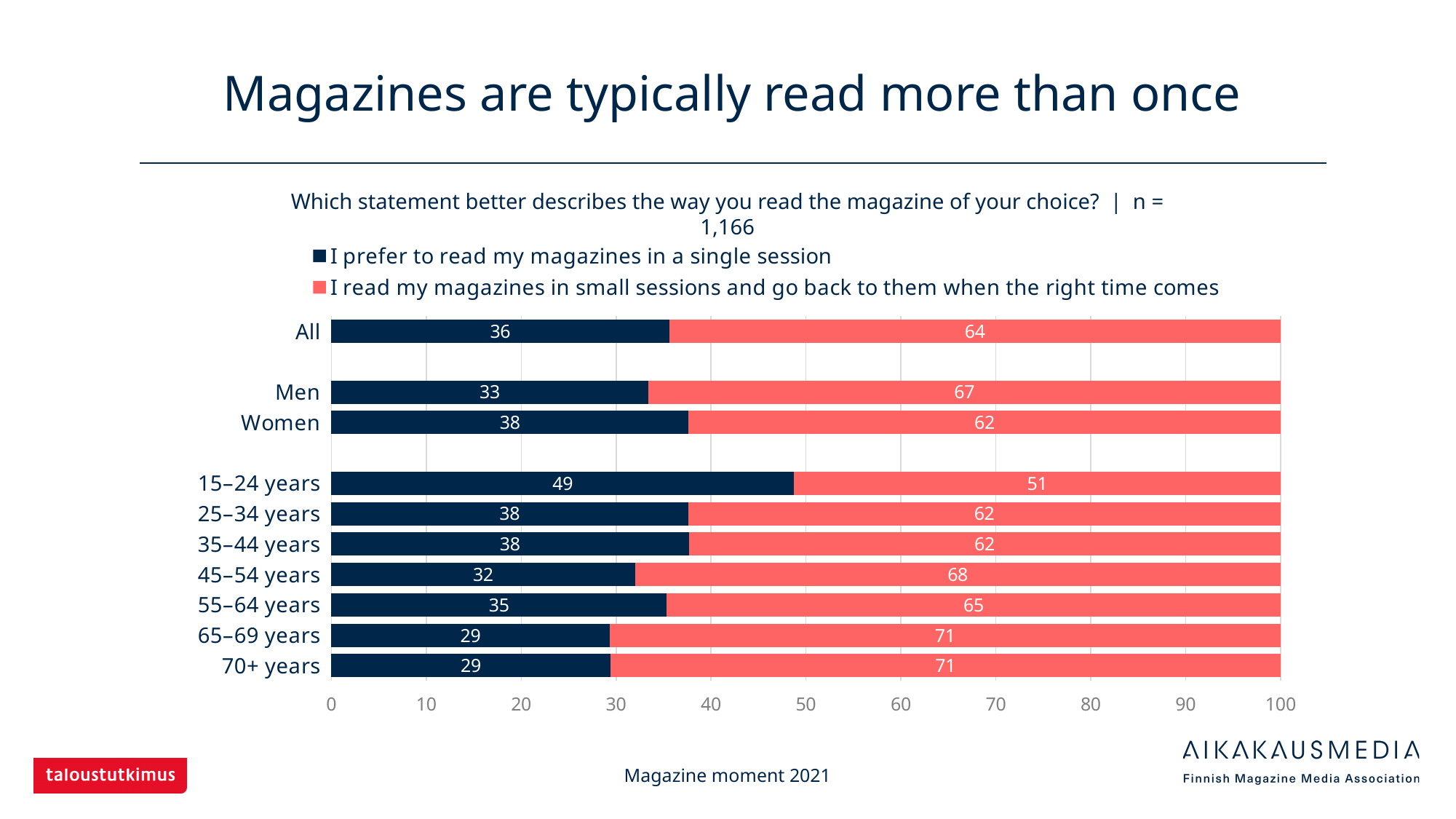
How many series does the legend list? 2 Which category has the lowest value for 'I read my magazines in small sessions and go back to them when the right time comes'? 15–24 years What is the value for 45–54 years for 'I prefer to read my magazines in a single session'? 32 What percentage of all respondents prefer to read their magazines in a single session? 36 What kind of chart is shown on the slide? Stacked bar chart Which is larger for 'I prefer to read my magazines in a single session': 55–64 years or 65–69 years? 55–64 years Which age group has the highest value for 'I prefer to read my magazines in a single session'? 15–24 years What is the value for Men for 'I read my magazines in small sessions and go back to them when the right time comes'? 67 What is the sample size (n) stated in the chart title? 1,166 How many categories are shown on the chart? 10 What is the total of the stacked bar for 70+ years? 100 What is the difference between Women and Men for 'I prefer to read my magazines in a single session'? 5